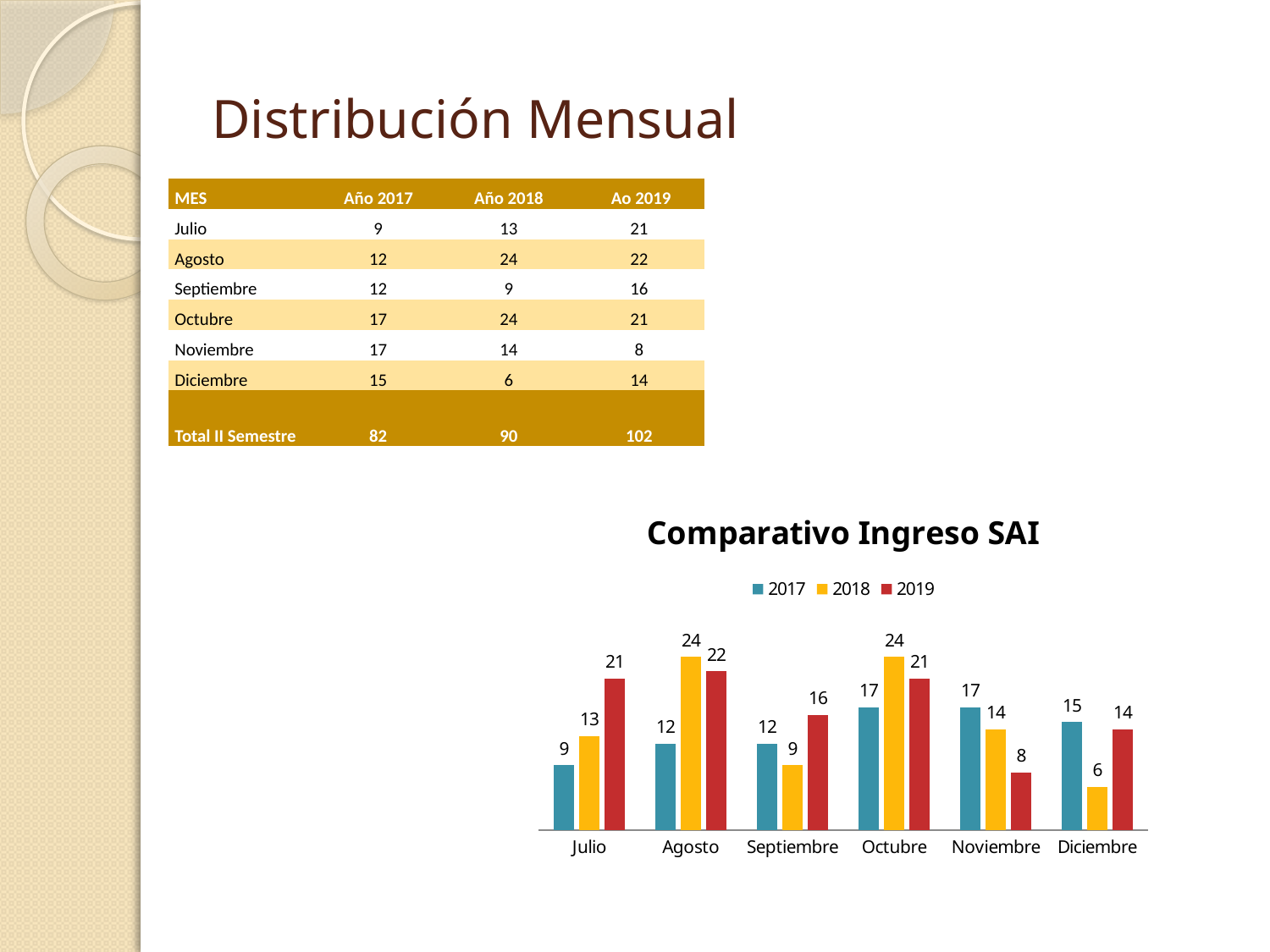
What kind of chart is shown on the slide? Bar chart What is the value for 2017 in Octubre? 17 Which month has the lowest value for the 2019 series? Noviembre How many series does the chart legend list? 3 What is the difference between the 2018 and 2017 values in Agosto? 12 Which month has the lowest value for the 2017 series? Julio What is the title of the chart? Comparativo Ingreso SAI How many months are shown on the x axis of the chart? 6 Which is larger in Septiembre, the 2018 value or the 2019 value? 2019 What is the value for 2018 in Diciembre? 6 Do the 2019 values rise or fall from Octubre to Noviembre? Fall What is the value for 2019 in Julio? 21